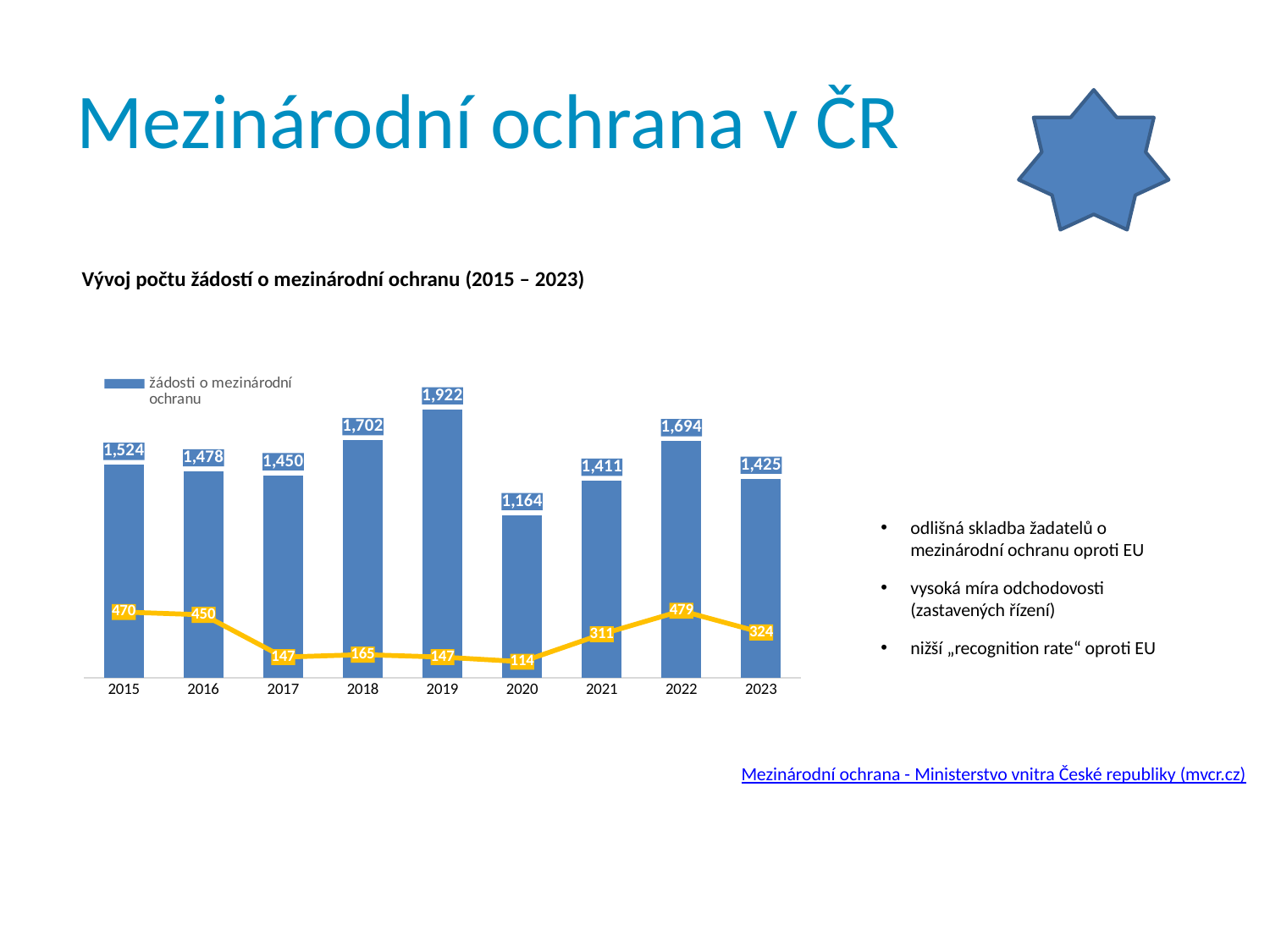
What is the value of the yellow line for 2022? 479 How many years are shown on the x axis? 9 Which year has the lowest bar value? 2020 What is the difference between the bar values for 2019 and 2020? 758 How many series does the legend list? 1 What is the legend entry shown for the bars? žádosti o mezinárodní ochranu Which is larger, the bar value for 2018 or for 2022? 2018 What kind of chart is shown on the slide? Bar chart with a line What is the value of the bar for 2019? 1,922 What is the value of the bar for 2020? 1,164 Which year has the highest bar value? 2019 Which year has the lowest value on the yellow line? 2020